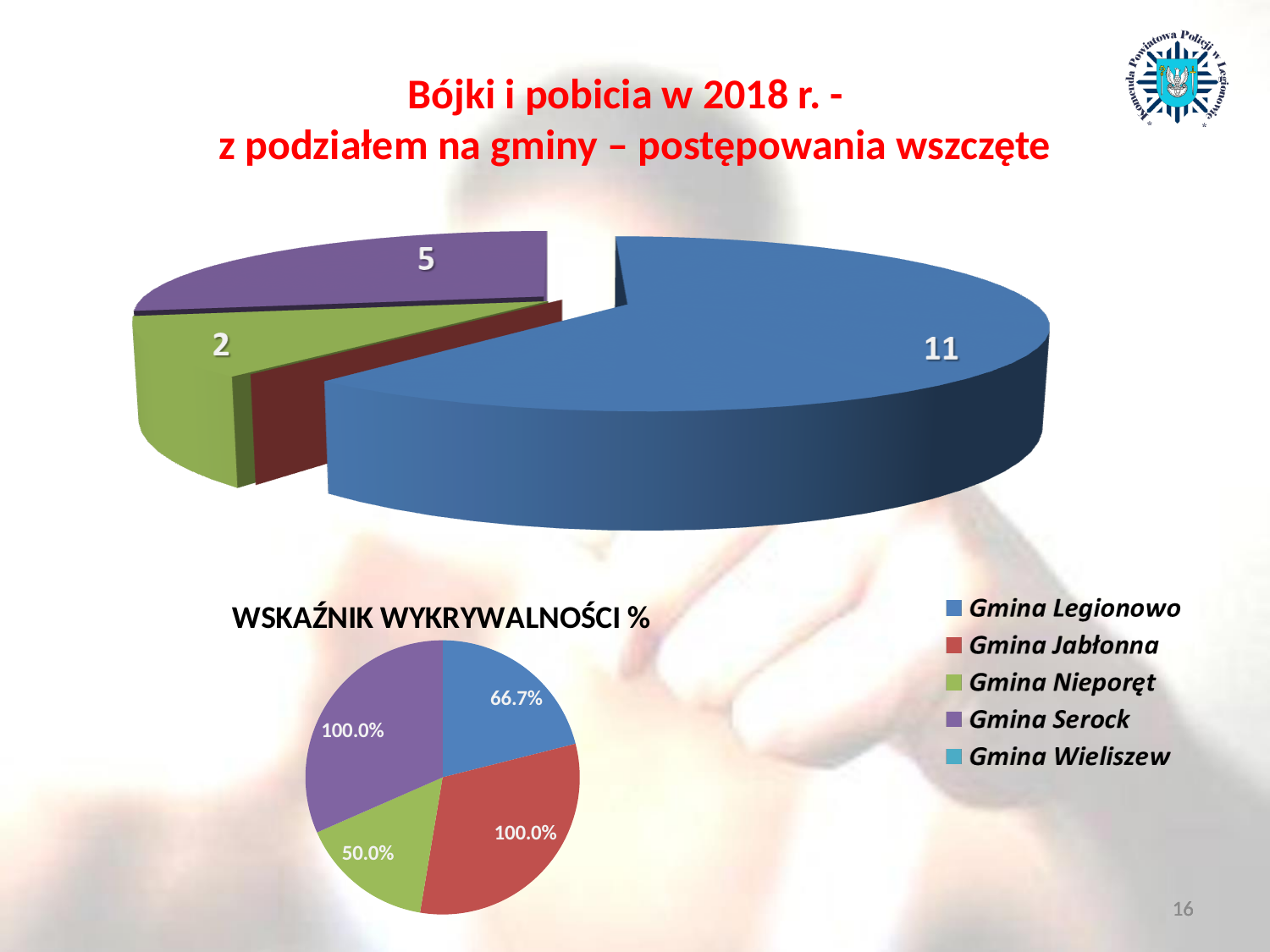
In the top pie chart, what is the value for Gmina Nieporęt? 2 In the top pie chart, which gmina has the highest value? Gmina Legionowo In the top pie chart, what is the value for Gmina Serock? 5 In the chart titled WSKAŹNIK WYKRYWALNOŚCI %, what is the value for Gmina Nieporęt? 50.0% In the chart titled WSKAŹNIK WYKRYWALNOŚCI %, what is the difference between the values for Gmina Jabłonna and Gmina Legionowo? 33.3% In the top pie chart, which is larger: the value for Gmina Serock or for Gmina Nieporęt? Gmina Serock In the top pie chart, what is the difference between the values for Gmina Legionowo and Gmina Serock? 6 How many entries does the legend on the slide list? 5 What kind of chart is the top chart on the slide? Pie chart In the chart titled WSKAŹNIK WYKRYWALNOŚCI %, which gmina has the lowest value? Gmina Nieporęt In the top pie chart, what is the value for Gmina Legionowo? 11 In the chart titled WSKAŹNIK WYKRYWALNOŚCI %, what is the value for Gmina Legionowo? 66.7%